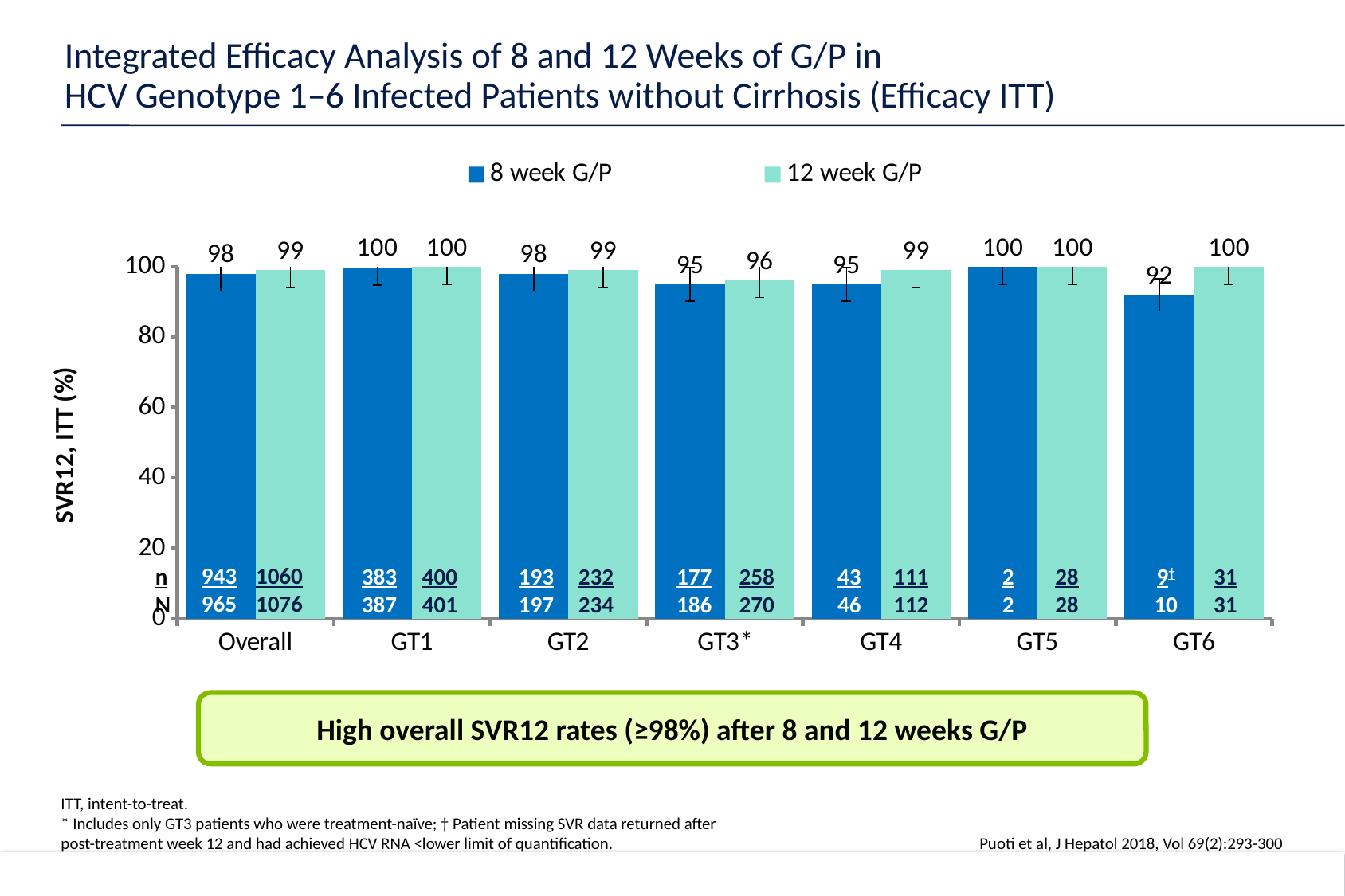
What kind of chart is shown on the slide? bar chart What is the n value shown for the 8 week G/P group in GT1? 383 What is the SVR12 rate for the 8 week G/P group in the Overall category? 98 What is the SVR12 rate for the 12 week G/P group in GT3*? 96 What is the difference between the 12 week G/P and 8 week G/P SVR12 rates in GT6? 8 Which category has the lowest SVR12 rate for the 8 week G/P group? GT6 What is the y-axis label of the chart? SVR12, ITT (%) What is the difference between the 12 week G/P and 8 week G/P SVR12 rates in GT4? 4 How many categories are shown on the x axis? 7 How many series does the legend list? 2 What is the SVR12 rate for the 8 week G/P group in GT6? 92 Which is larger in GT3*: the 8 week G/P SVR12 rate or the 12 week G/P SVR12 rate? 12 week G/P